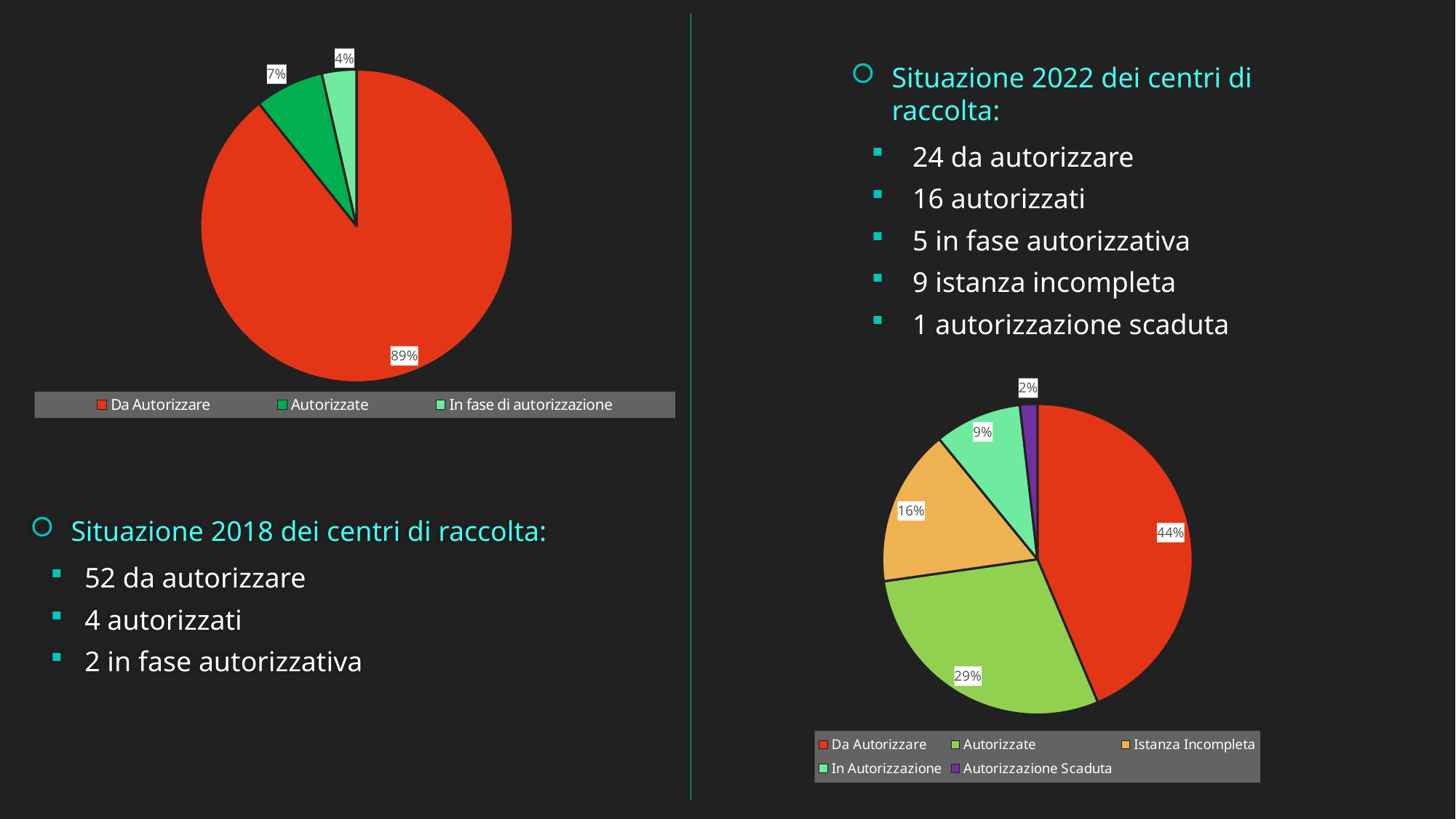
In the pie chart on the right, what share does Istanza Incompleta have? 16% In the pie chart on the left, which category has the smallest slice? In fase di autorizzazione How many categories does the legend of the pie chart on the right list? 5 In the pie chart on the right, which is larger: In Autorizzazione or Istanza Incompleta? Istanza Incompleta In the pie chart on the right, what share does Da Autorizzare have? 44% In the pie chart on the left, what share does In fase di autorizzazione have? 4% How many slices does the pie chart on the left have? 3 In the pie chart on the right, which category has the largest slice? Da Autorizzare In the pie chart on the right, what is the difference in percentage points between Da Autorizzare and Autorizzate? 15